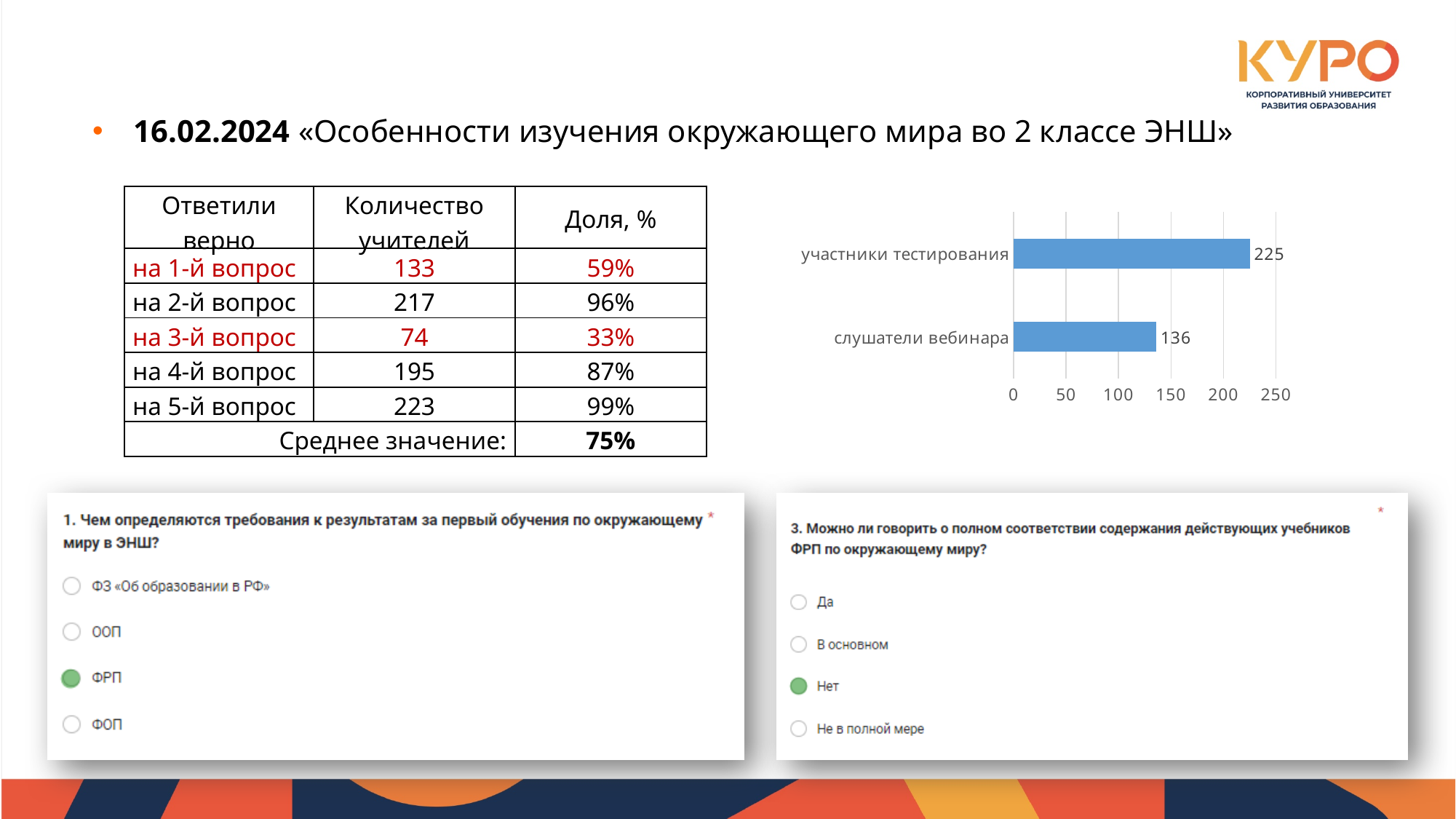
What is the difference between the values for участники тестирования and слушатели вебинара in the bar chart? 89 Is the value for участники тестирования greater or less than 200? greater What is the value for участники тестирования in the bar chart? 225 Which is larger in the bar chart: участники тестирования or слушатели вебинара? участники тестирования What kind of chart is shown on the slide? bar chart What colour are the bars in the bar chart? blue Which category has the lowest value in the bar chart? слушатели вебинара How many categories are shown in the bar chart? 2 Which category has the highest value in the bar chart? участники тестирования Is the value for слушатели вебинара greater or less than 150? less What is the value for слушатели вебинара in the bar chart? 136 What is the maximum value shown on the x axis of the bar chart? 250